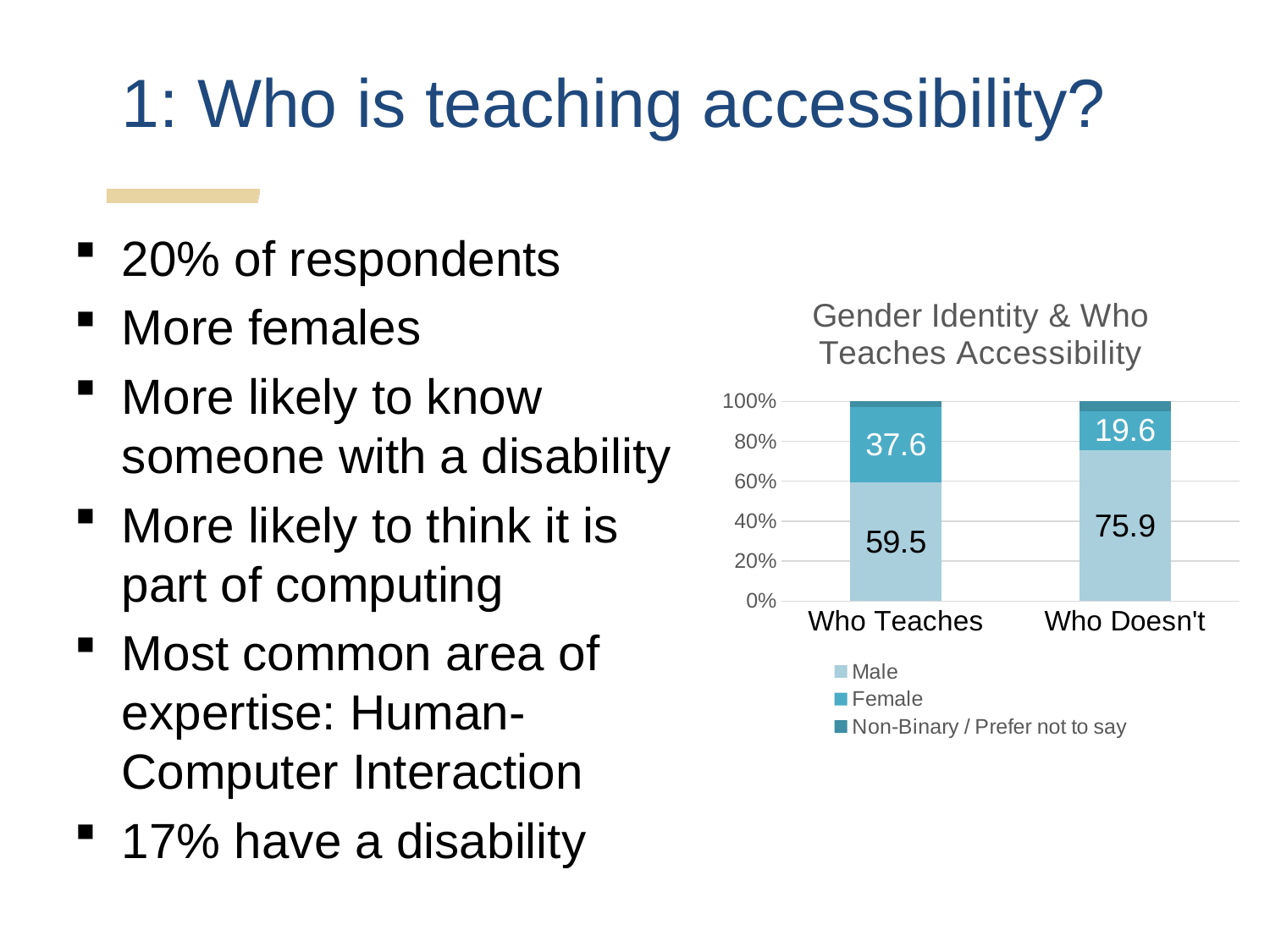
How many categories are shown on the x axis of the chart? 2 What is the difference between the Female values for Who Teaches and Who Doesn't? 18 What is the Female value for the Who Doesn't bar? 19.6 Which category has the larger Female value, Who Teaches or Who Doesn't? Who Teaches What is the title of the chart? Gender Identity & Who Teaches Accessibility What is the Male value for the Who Doesn't bar? 75.9 What type of chart is shown on the slide? Stacked bar chart Is the Non-Binary / Prefer not to say value for Who Teaches greater or less than 20%? less What is the Male value for the Who Teaches bar? 59.5 How many series does the chart legend list? 3 What is the Female value for the Who Teaches bar? 37.6 What is the difference between the Male values for Who Doesn't and Who Teaches? 16.4